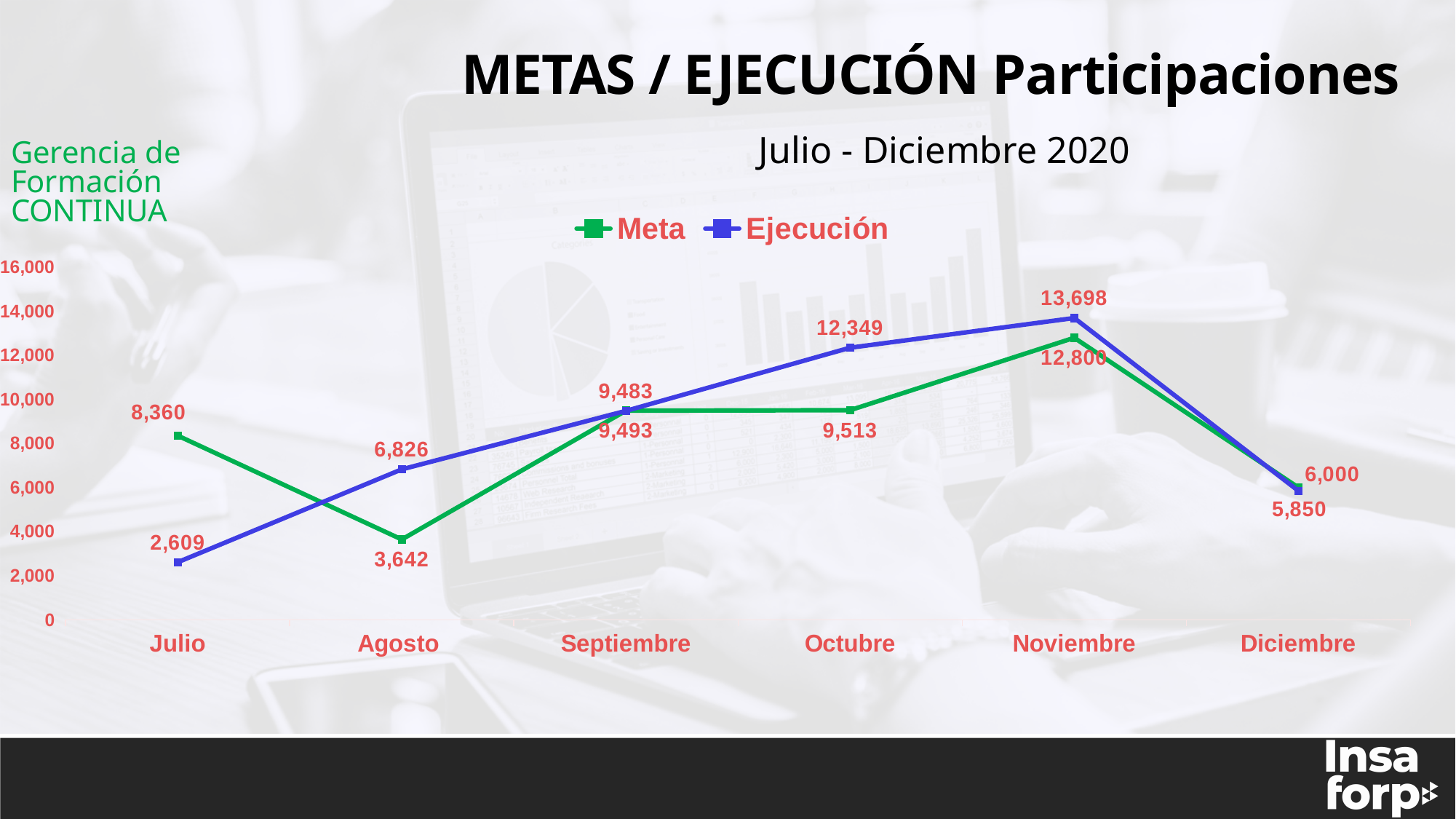
In which month is the Ejecución value highest? Noviembre What is the difference between Ejecución and Meta in Noviembre? 898 How many months are shown on the x axis? 6 What is the Meta value for Octubre? 9,513 What kind of chart is shown on the slide? Line chart How many series does the legend list? 2 What is the Meta value for Julio? 8,360 What is the Ejecución value for Julio? 2,609 What is the Ejecución value for Noviembre? 13,698 In Agosto, which series has the larger value, Meta or Ejecución? Ejecución In which month is the Meta value lowest? Agosto What is the Ejecución value for Agosto? 6,826